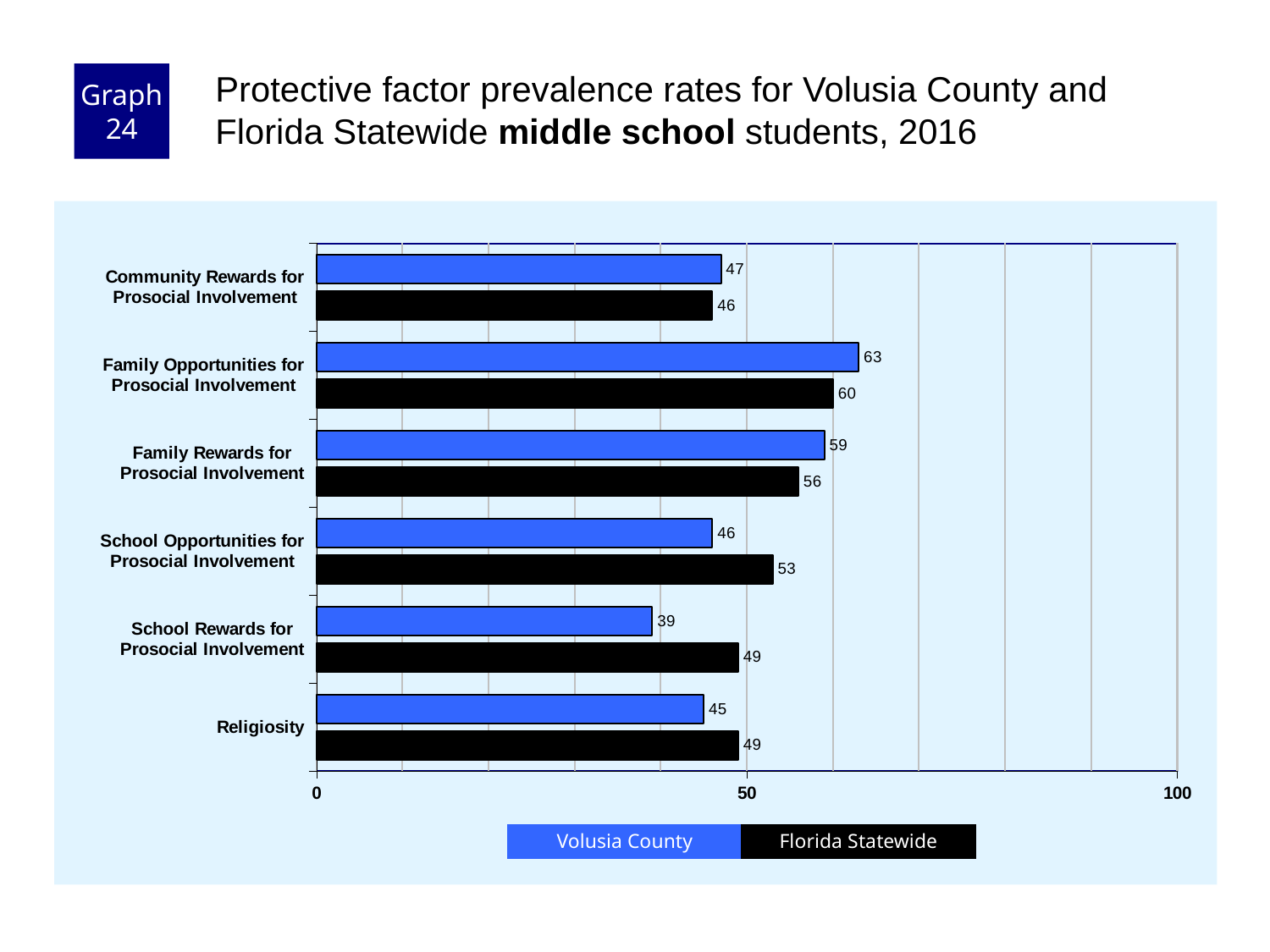
For Family Rewards for Prosocial Involvement, which is larger: Volusia County or Florida Statewide? Volusia County How many categories are shown on the chart? 6 What is the difference between the Florida Statewide and Volusia County values for School Opportunities for Prosocial Involvement? 7 Which category has the highest Volusia County value? Family Opportunities for Prosocial Involvement What is the Florida Statewide value for School Rewards for Prosocial Involvement? 49 What is the Volusia County value for Family Opportunities for Prosocial Involvement? 63 What is the Volusia County value for Religiosity? 45 Is the Florida Statewide value for Family Opportunities for Prosocial Involvement greater or less than 50? greater What kind of chart is shown on the slide? bar chart How many series does the legend list? 2 Which category has the lowest Volusia County value? School Rewards for Prosocial Involvement Which colour represents Florida Statewide in the chart? black